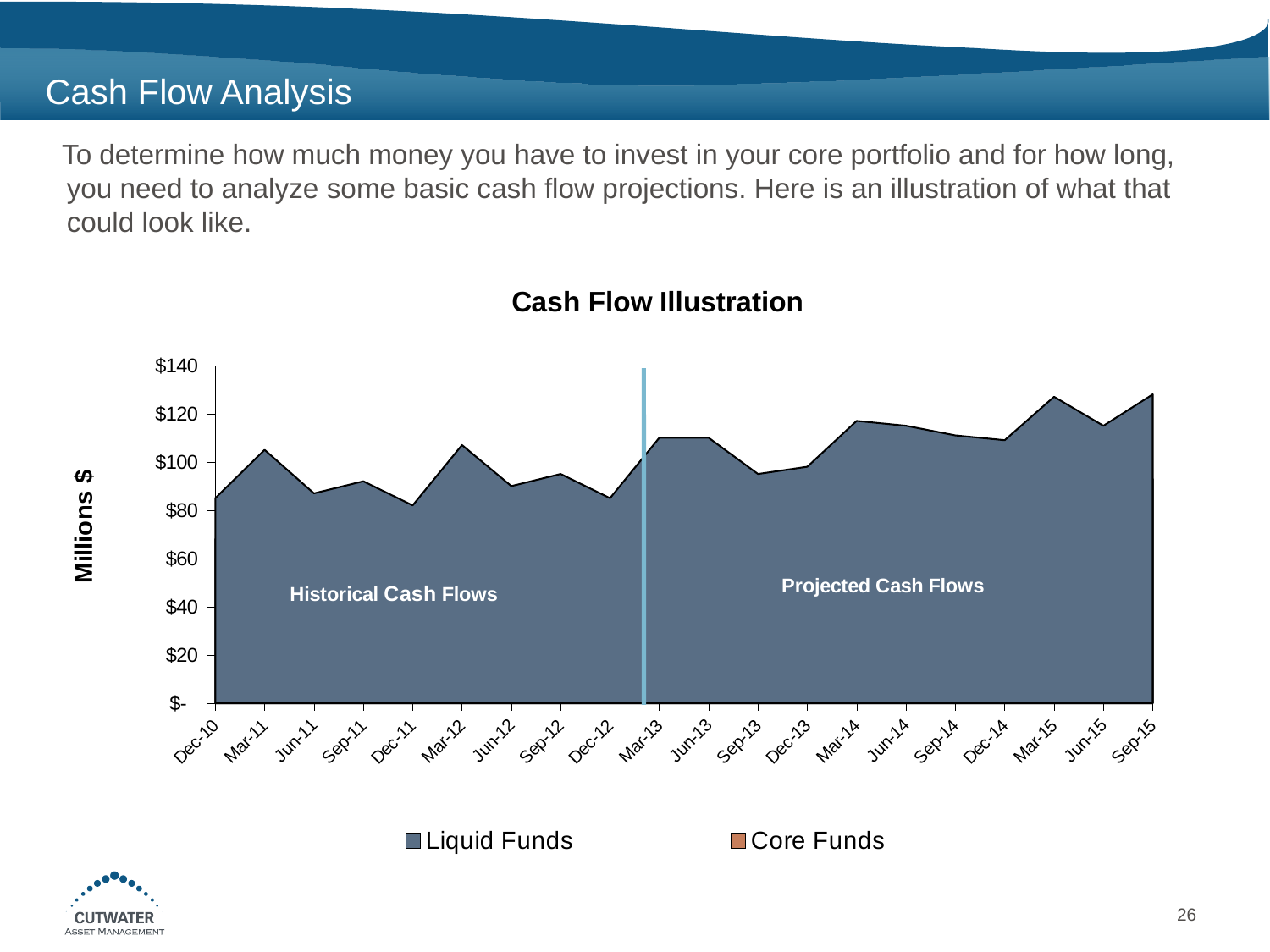
Is the value for Sep-15 greater or less than $120? greater Which is larger, the value for Mar-14 or the value for Dec-11? Mar-14 Do the values in the Cash Flow Illustration chart generally rise or fall from Dec-10 to Sep-15? rise What is the label on the vertical axis of the Cash Flow Illustration chart? Millions $ What kind of chart is the Cash Flow Illustration? Area chart How many time periods are shown on the x axis of the Cash Flow Illustration chart? 20 What are the two series named in the legend of the Cash Flow Illustration chart? Liquid Funds and Core Funds How many series does the legend of the Cash Flow Illustration chart list? 2 Is the value for Dec-11 greater or less than $100? less Is the value for Mar-14 greater or less than $100? greater